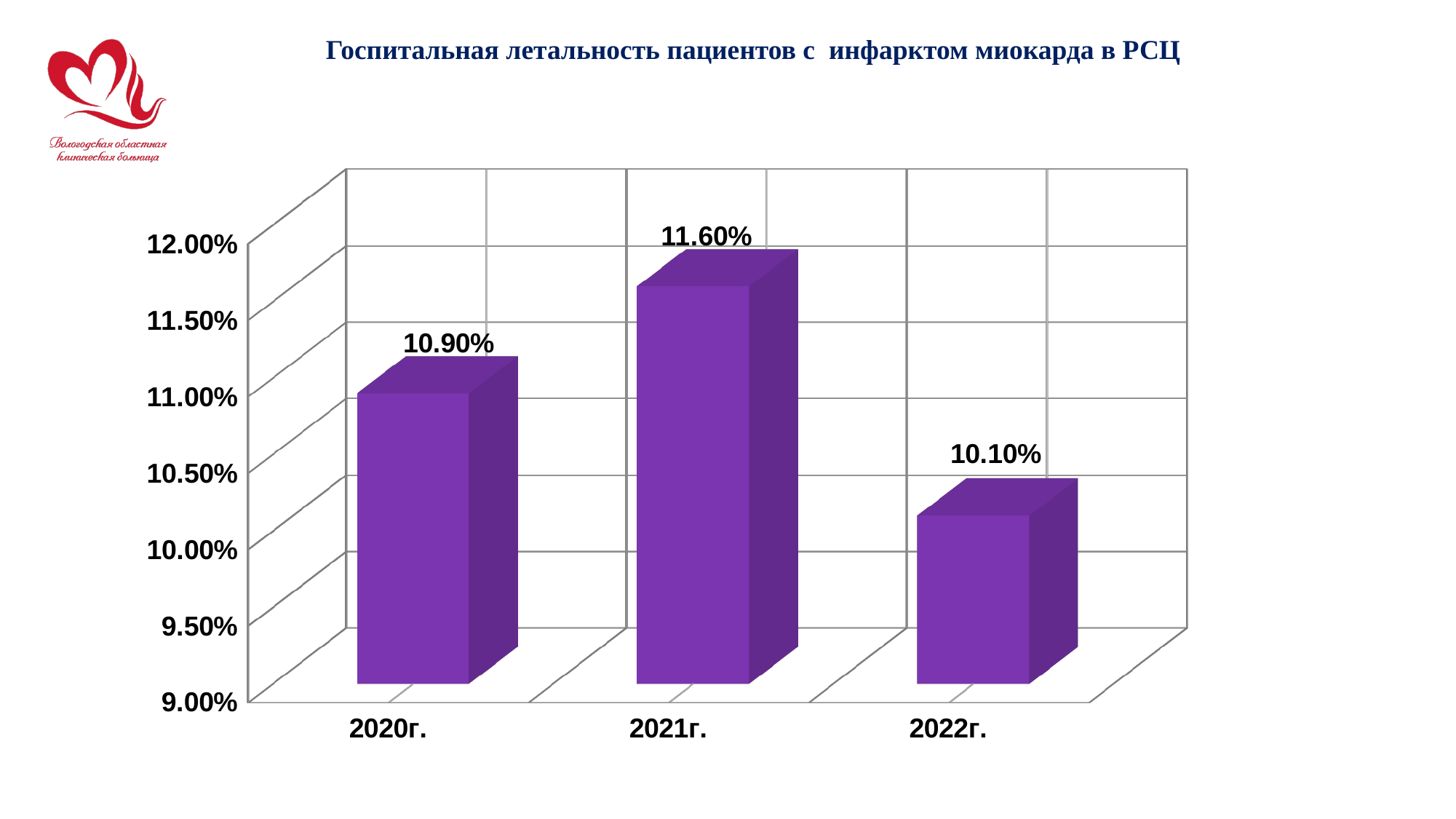
What is the title of the chart? Госпитальная летальность пациентов с инфарктом миокарда в РСЦ Which year has the lowest hospital mortality? 2022г. How many years are shown on the x axis? 3 What kind of chart is shown on the slide? bar chart What is the difference between the values for 2021г. and 2022г.? 1.50% What is the hospital mortality value for 2021г.? 11.60% Is the value for 2021г. greater or less than 11.00%? greater What is the difference between the values for 2020г. and 2022г.? 0.80% What is the hospital mortality value for 2020г.? 10.90% Which year has the highest hospital mortality? 2021г. Which is larger, the value for 2020г. or the value for 2022г.? 2020г. What is the hospital mortality value for 2022г.? 10.10%